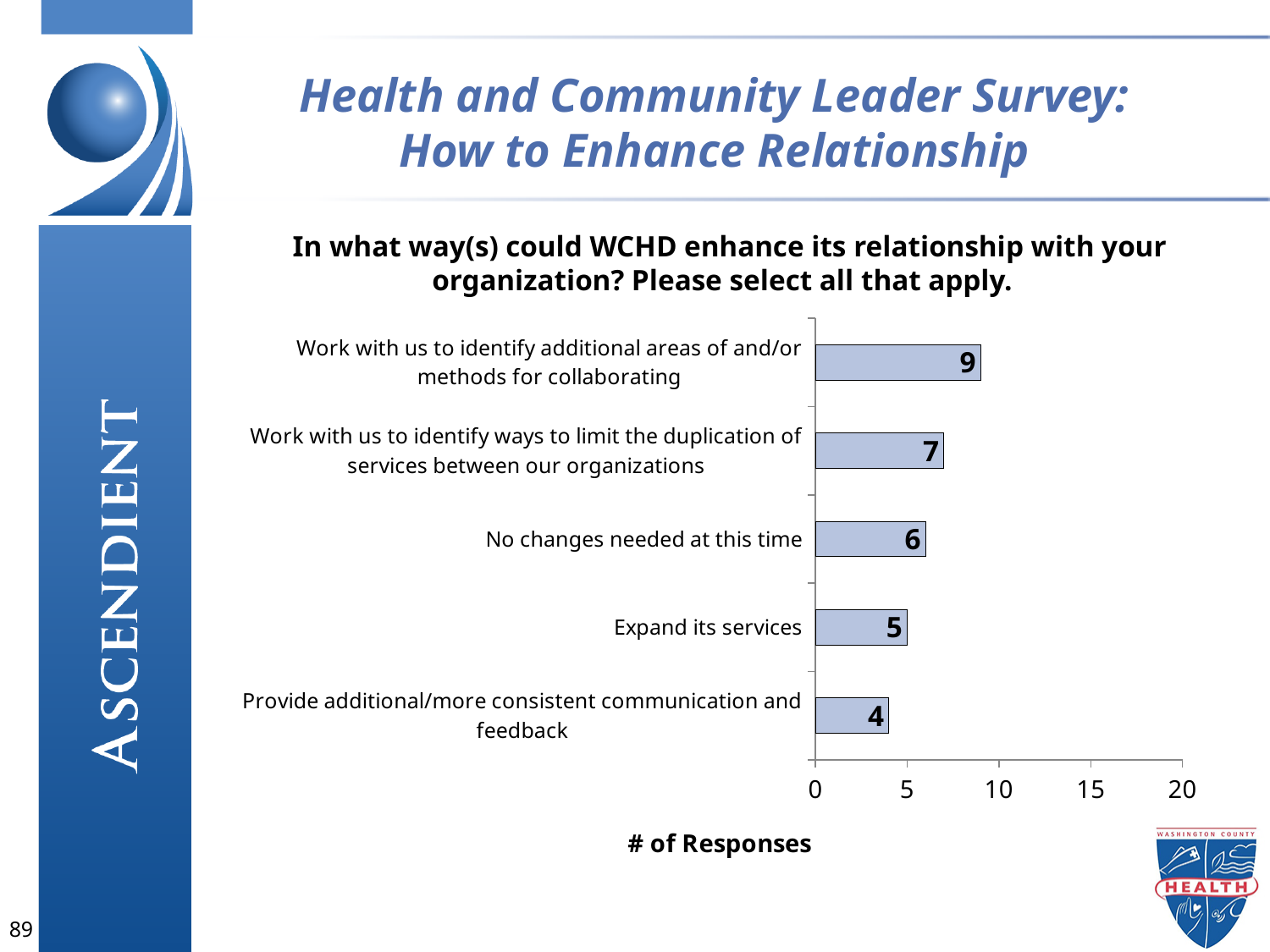
Is the value for "Work with us to identify ways to limit the duplication of services between our organizations" greater or less than 10? less What is the difference in responses between "Work with us to identify additional areas of and/or methods for collaborating" and "Work with us to identify ways to limit the duplication of services between our organizations"? 2 How many responses are shown for "Work with us to identify additional areas of and/or methods for collaborating"? 9 How many responses did "Expand its services" receive? 5 How many categories are shown in the chart? 5 What is the value for "No changes needed at this time"? 6 What is the label of the horizontal axis? # of Responses Which has more responses: "No changes needed at this time" or "Expand its services"? No changes needed at this time What kind of chart is shown on the slide? bar chart What is the value for "Provide additional/more consistent communication and feedback"? 4 Which category has the highest number of responses? Work with us to identify additional areas of and/or methods for collaborating Which category has the lowest number of responses? Provide additional/more consistent communication and feedback